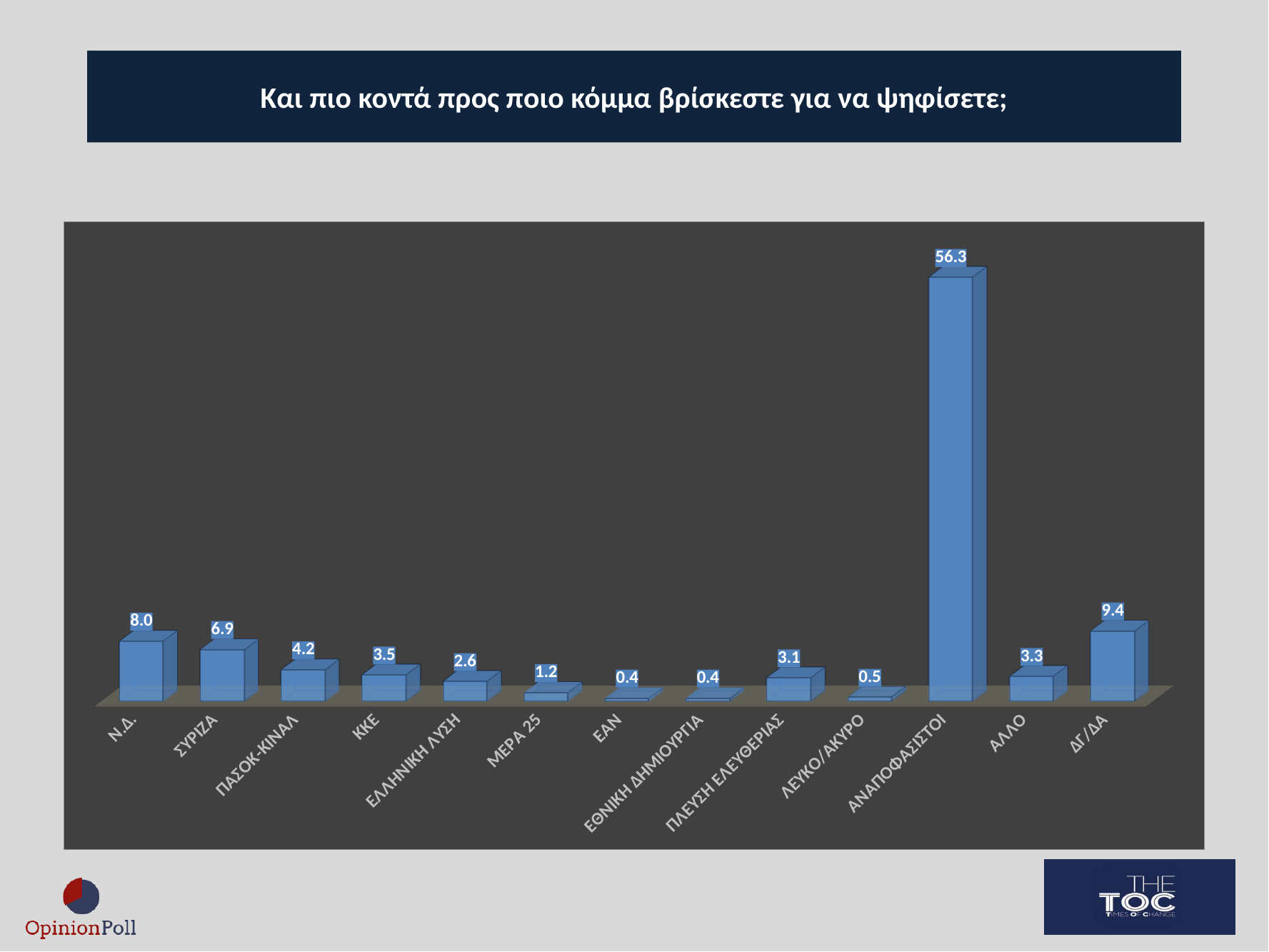
Which is larger, the value for ΚΚΕ or the value for ΠΑΣΟΚ-ΚΙΝΑΛ? ΠΑΣΟΚ-ΚΙΝΑΛ What is the value for ΣΥΡΙΖΑ? 6.9 What is the value for ΠΛΕΥΣΗ ΕΛΕΥΘΕΡΙΑΣ? 3.1 Which is larger, the value for ΜΕΡΑ 25 or the value for ΛΕΥΚΟ/ΑΚΥΡΟ? ΜΕΡΑ 25 What is the value for Ν.Δ.? 8.0 What is the value for ΑΝΑΠΟΦΑΣΙΣΤΟΙ? 56.3 What is the value for ΔΓ/ΔΑ? 9.4 Which category has the highest value? ΑΝΑΠΟΦΑΣΙΣΤΟΙ What kind of chart is shown on the slide? Bar chart How many categories are shown in the chart? 13 What is the difference between the values for ΔΓ/ΔΑ and ΑΛΛΟ? 6.1 What is the difference between the values for Ν.Δ. and ΣΥΡΙΖΑ? 1.1